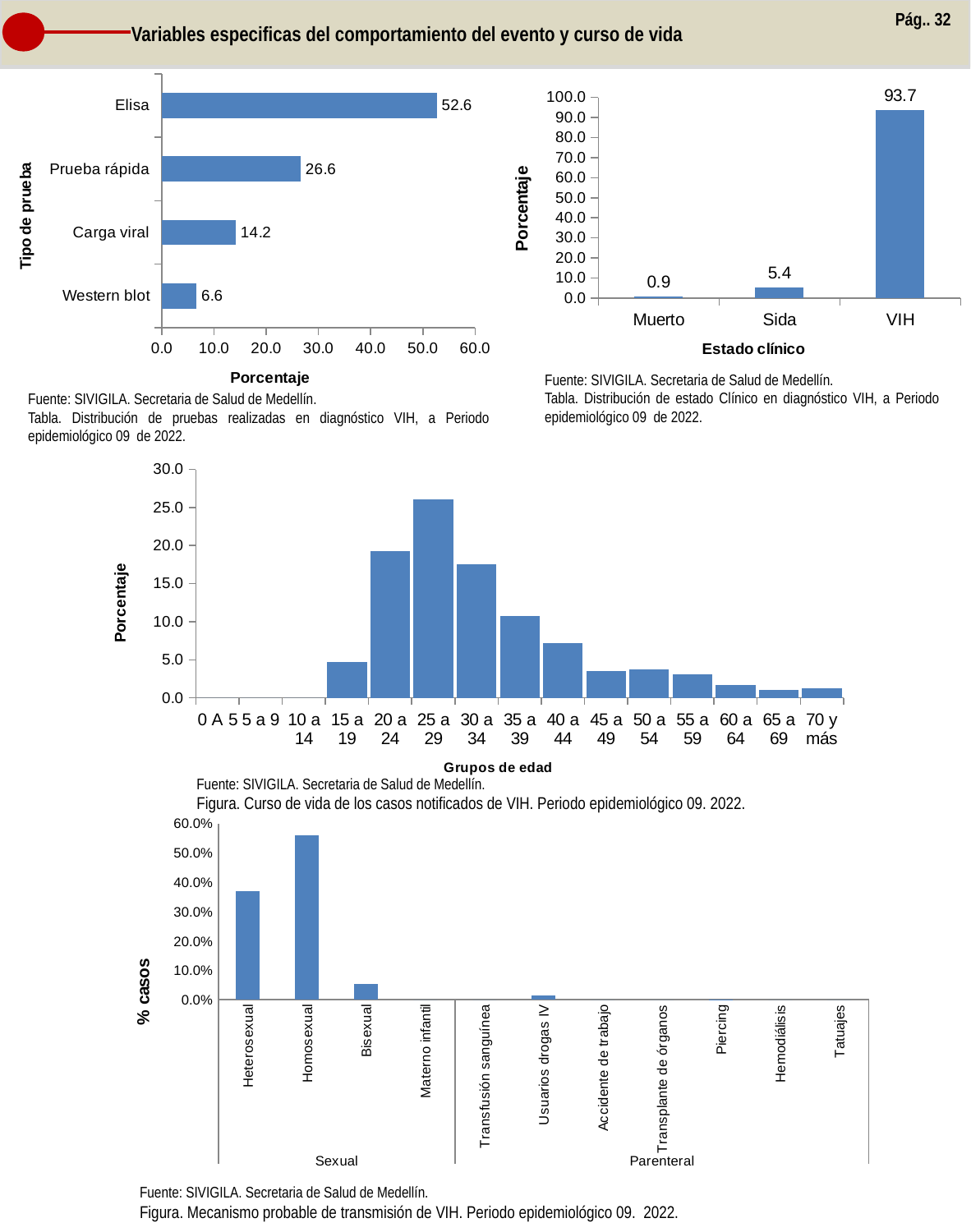
In the bottom chart (Mecanismo probable de transmisión), which category has the highest share of cases? Homosexual In the top-right chart (Estado clínico), what is the value for Sida? 5.4 In the middle chart (Grupos de edad), which age group has the highest percentage? 25 a 29 In the top-right chart (Estado clínico), what is the difference between VIH and Sida? 88.3 In the top-right chart (Estado clínico), which category has the highest percentage? VIH In the top-left chart (Tipo de prueba), which test type has the lowest percentage? Western blot In the top-left chart (Tipo de prueba), what is the value for Elisa? 52.6 In the top-left chart (Tipo de prueba), what is the difference between Elisa and Prueba rápida? 26.0 In the bottom chart (Mecanismo probable de transmisión), is the value for Heterosexual greater or less than 30.0%? greater In the middle chart (Grupos de edad), is the value for 20 a 24 greater or less than 15.0? greater In the top-left chart (Tipo de prueba), how many test types are shown? 4 In the middle chart (Grupos de edad), which is larger, the value for 30 a 34 or the value for 35 a 39? 30 a 34